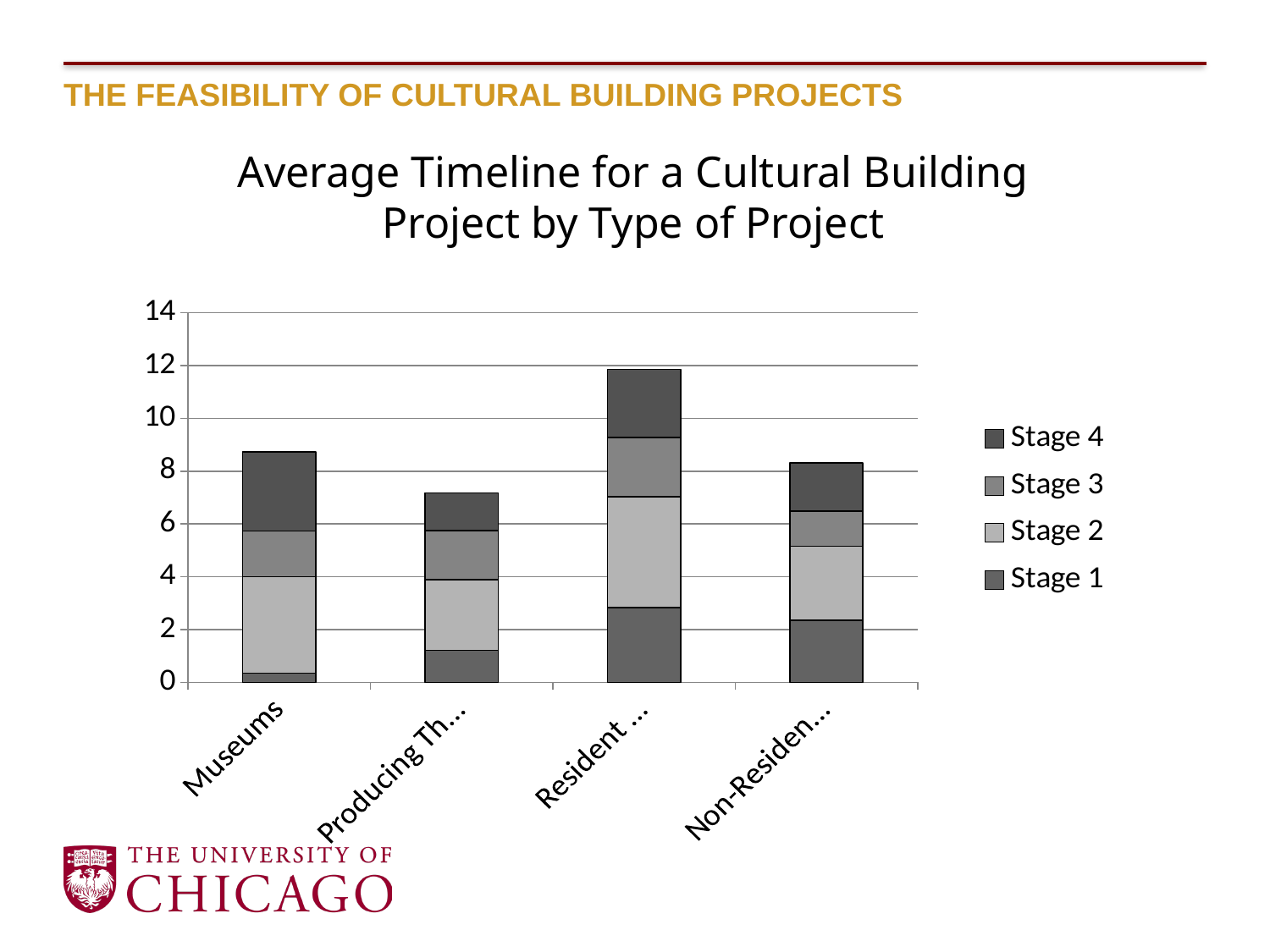
Which category has the shortest stacked bar? Producing Th... (second bar from the left) Is the total height of the second bar from the left (Producing Th...) greater or less than 8? less Is the total height of the Museums bar greater or less than 8? greater How many series does the legend list? 4 How many project-type categories are plotted along the x axis? 4 Which legend entry is listed first (at the top of the legend)? Stage 4 What is the title of the chart? Average Timeline for a Cultural Building Project by Type of Project Which category has the tallest stacked bar? Resident ... (third bar from the left) What kind of chart is shown on the slide? Stacked bar chart Which bar is taller: Museums or the second bar from the left (Producing Th...)? Museums Is the Stage 1 segment of the Museums bar greater or less than 2? less